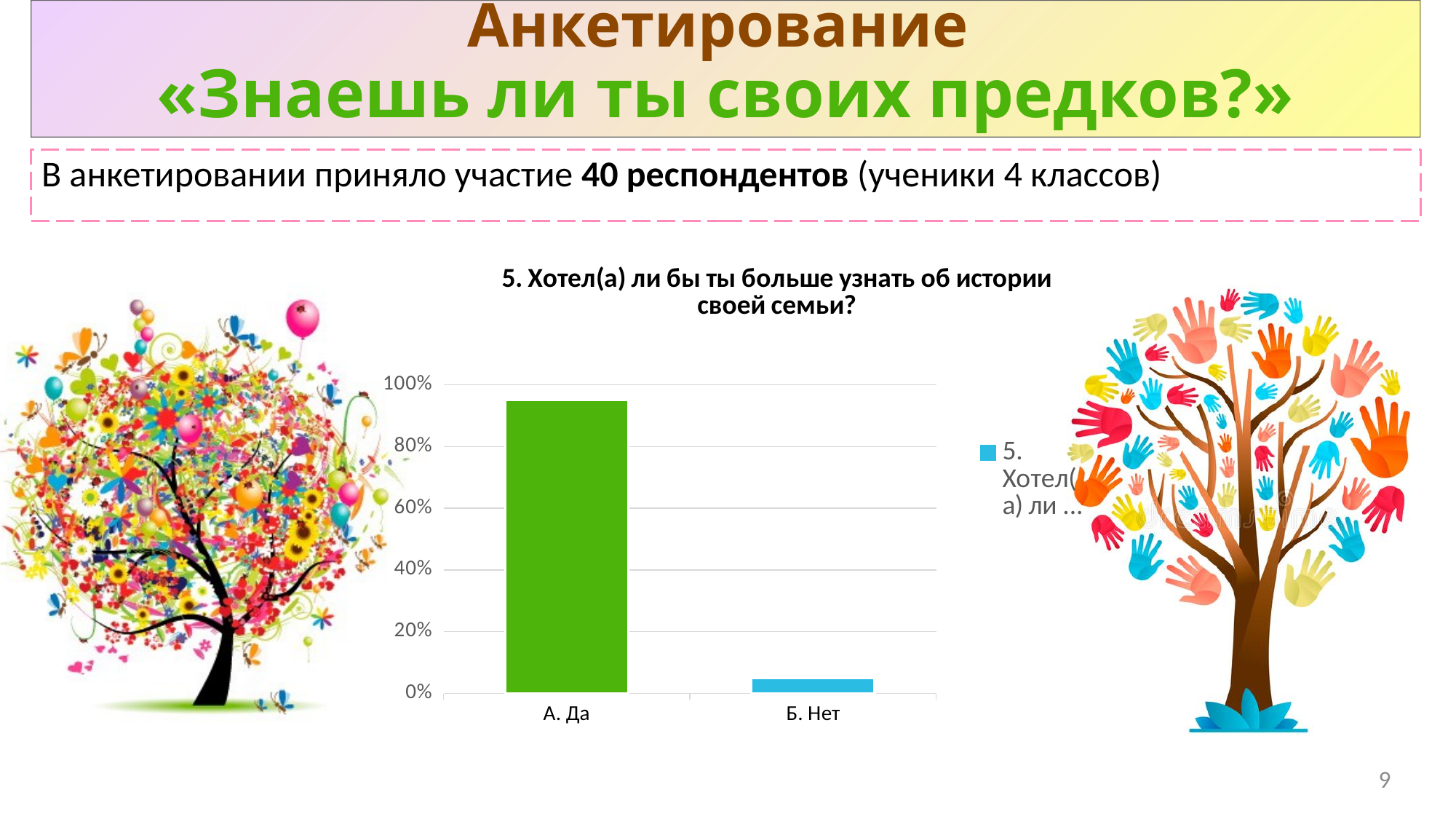
Which is larger, the value for А. Да or the value for Б. Нет? А. Да Is the value for Б. Нет greater or less than 20%? less Is the value for А. Да greater or less than 80%? greater What kind of chart is shown on the slide? bar chart Which category has the lowest bar in the chart? Б. Нет Is the value for А. Да greater or less than 60%? greater How many series does the chart legend list? 1 What is the highest value shown on the chart's vertical axis? 100% What colour is the bar for А. Да? green Which category has the highest bar in the chart? А. Да What is the title of the chart? 5. Хотел(а) ли бы ты больше узнать об истории своей семьи? How many categories are shown on the x axis of the chart? 2